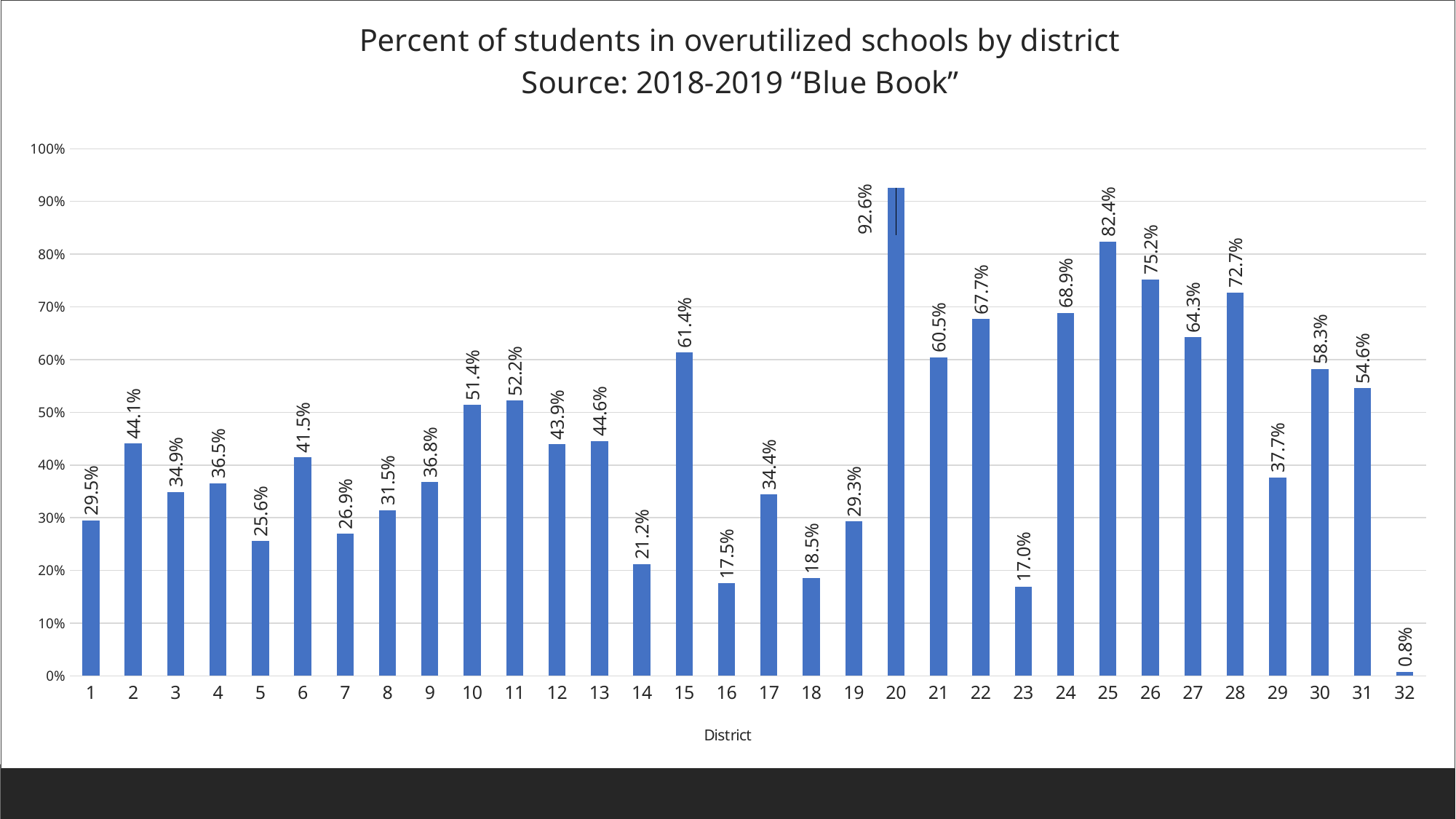
What kind of chart is shown on the slide? Bar chart Which district has the lowest percent of students in overutilized schools? 32 What is the difference between the values for district 25 and district 26? 7.2% What source is cited in the chart title? 2018-2019 "Blue Book" Which district has the highest percent of students in overutilized schools? 20 What is the value shown for district 15? 61.4% Is the value for district 28 greater or less than 70%? greater What is the title of the chart? Percent of students in overutilized schools by district Which district has a larger value, district 10 or district 11? 11 How many districts are shown on the x axis? 32 What percent of students are in overutilized schools in district 20? 92.6% What percent of students are in overutilized schools in district 32? 0.8%